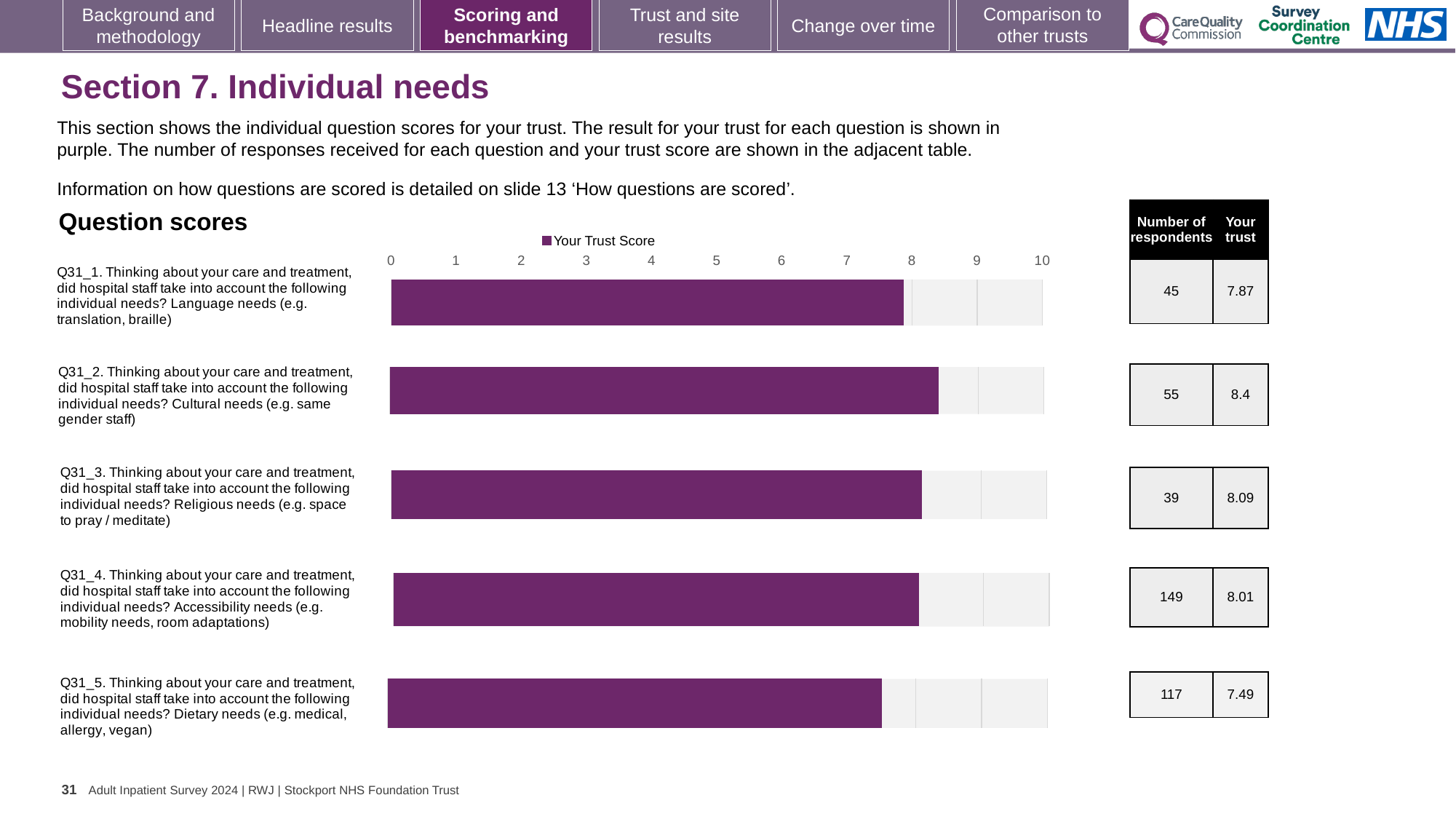
What is the difference between the trust scores for Q31_2 and Q31_5? 0.91 How many series does the legend list? 1 Which question has the highest trust score? Q31_2 (Cultural needs) Is the trust score for Q31_5 (Dietary needs) greater or less than 8? less What is the trust score for Q31_1 (Language needs)? 7.87 Which question has the lowest trust score? Q31_5 (Dietary needs) How many questions are plotted in the chart? 5 Which has a higher trust score, Q31_3 (Religious needs) or Q31_1 (Language needs)? Q31_3 (Religious needs) What kind of chart is shown? Bar chart What is the trust score for Q31_2 (Cultural needs)? 8.4 What is the trust score for Q31_5 (Dietary needs)? 7.49 How many respondents answered Q31_4 (Accessibility needs)? 149